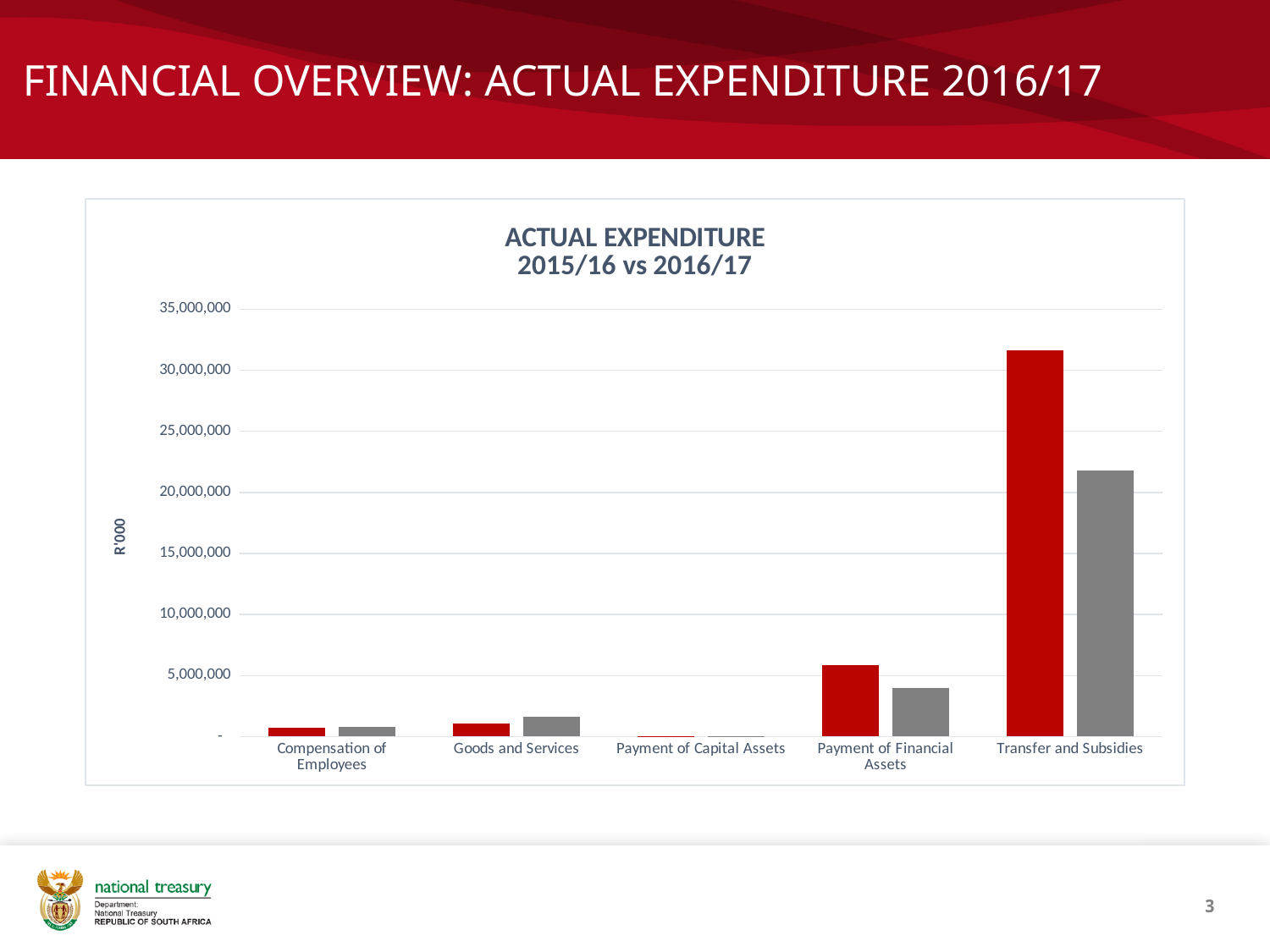
For Transfer and Subsidies, which bar is larger, the red bar or the grey bar? the red bar What kind of chart is shown on the slide? bar chart For Goods and Services, which bar is larger, the red bar or the grey bar? the grey bar Which category has the lowest expenditure in the chart? Payment of Capital Assets Which category has the highest expenditure in the chart? Transfer and Subsidies Is the value of the red bar for Transfer and Subsidies greater or less than 30,000,000? greater What is the label on the vertical axis of the chart? R'000 What is the title of the chart? ACTUAL EXPENDITURE 2015/16 vs 2016/17 Is the value of the grey bar for Payment of Financial Assets greater or less than 5,000,000? less Is the value of the grey bar for Transfer and Subsidies greater or less than 25,000,000? less How many expenditure categories are shown on the x axis of the chart? 5